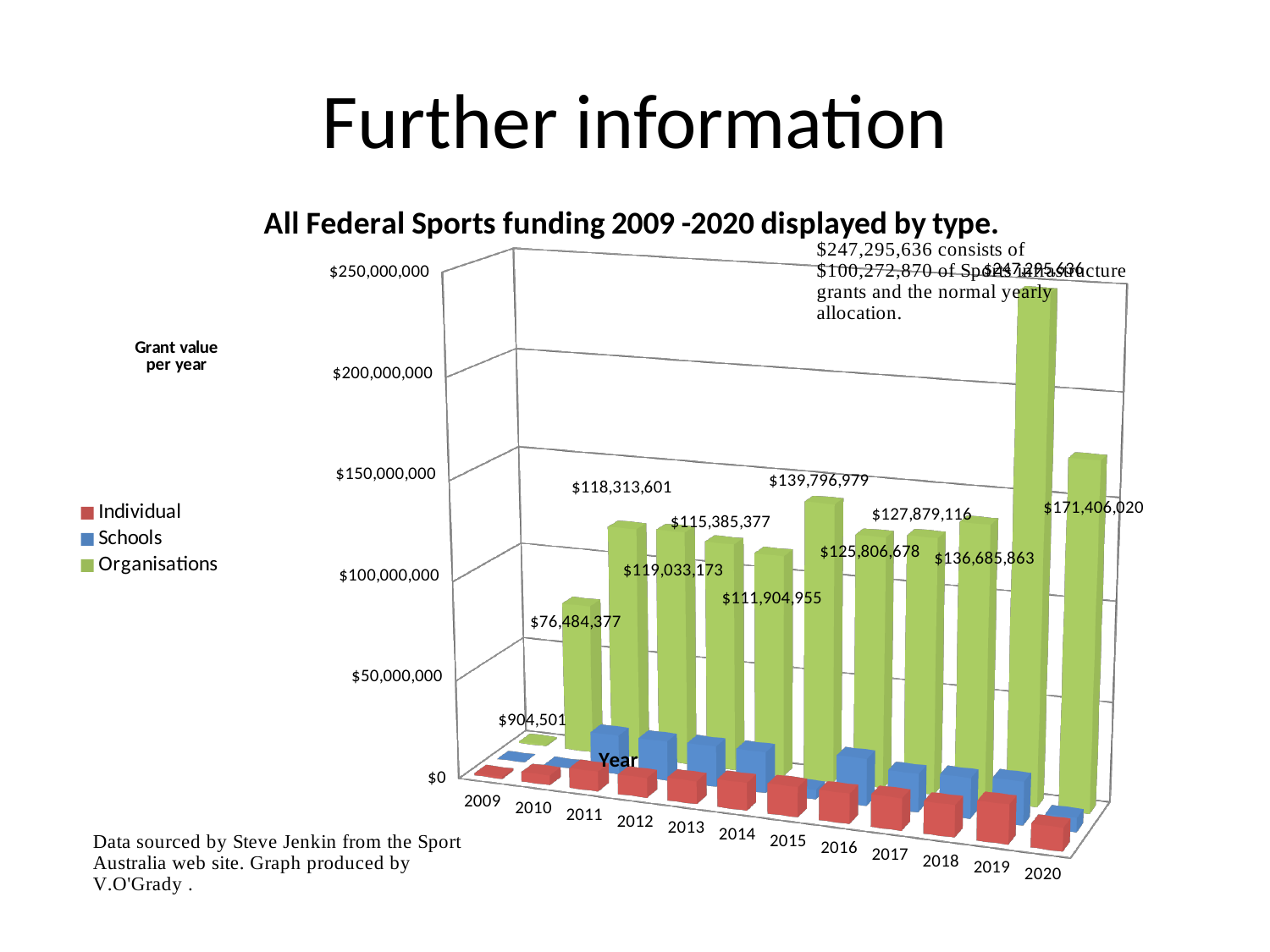
What is the Organisations grant value for 2010? $76,484,377 What is the difference between the Organisations grant values for 2020 and 2018? $34,720,157 How many series does the legend list? 3 What is the Organisations grant value for 2009? $904,501 What kind of chart is shown on the slide? Bar chart Is the Organisations grant value for 2010 greater or less than $100,000,000? less How many years are shown on the x axis of the chart? 12 Which year has the highest Organisations grant value? 2019 Which year has the lowest Organisations grant value? 2009 Which year has the larger Organisations grant value, 2010 or 2011? 2011 Which series is shown in green in the chart? Organisations What is the Organisations grant value for 2015? $139,796,979